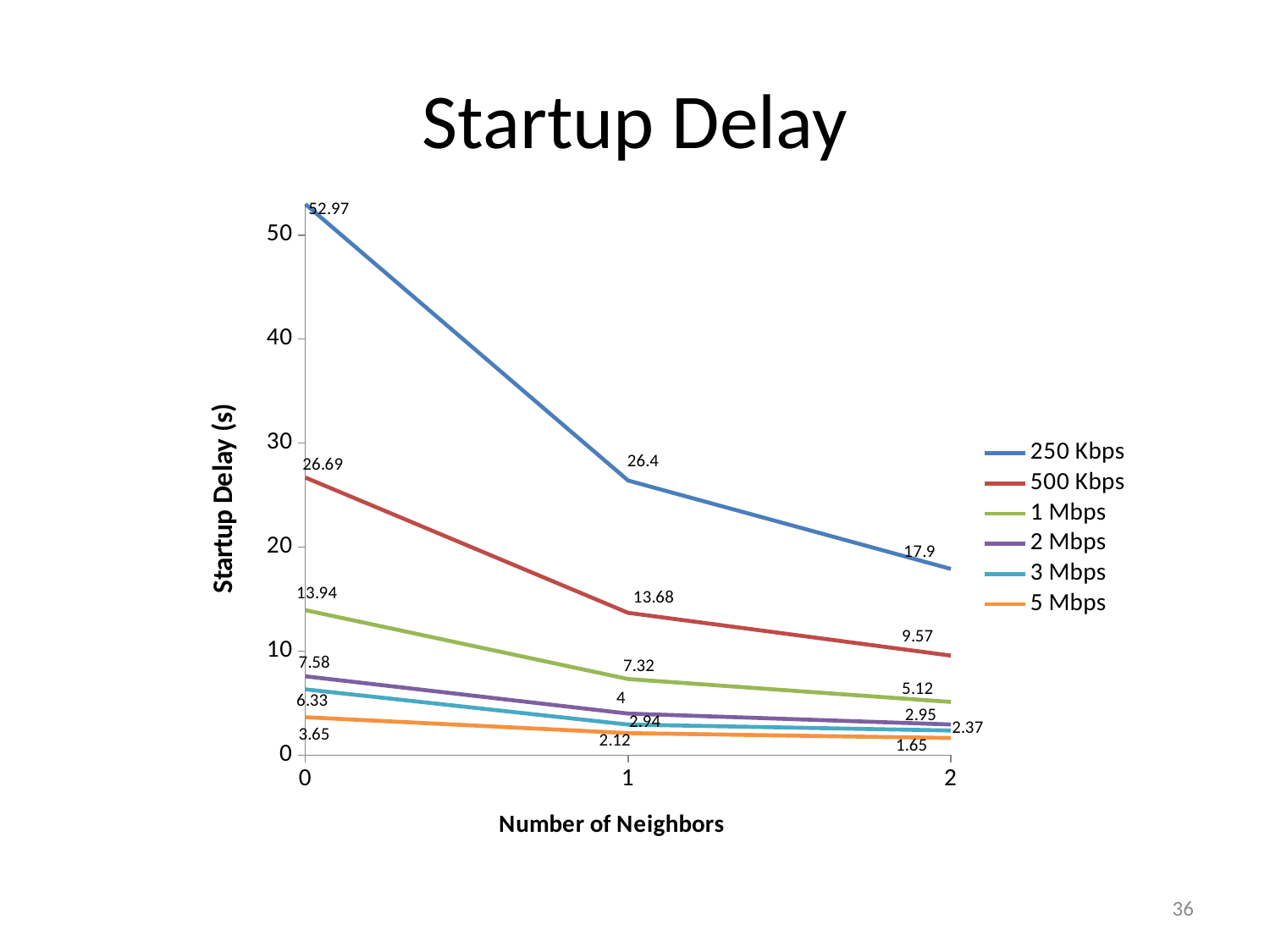
What is the startup delay for 1 Mbps at 2 neighbors? 5.12 What is the startup delay for 500 Kbps at 1 neighbor? 13.68 Which series has the highest startup delay at 2 neighbors? 250 Kbps What kind of chart is shown on the slide? Line chart Does the startup delay for 250 Kbps rise or fall as the number of neighbors increases? Fall What is the startup delay for 250 Kbps at 0 neighbors? 52.97 Which series has the lowest startup delay at 0 neighbors? 5 Mbps Which is larger: the 500 Kbps delay at 2 neighbors or the 1 Mbps delay at 0 neighbors? 1 Mbps delay at 0 neighbors What is the startup delay for 5 Mbps at 0 neighbors? 3.65 What is the label of the y axis? Startup Delay (s) What is the difference between the 250 Kbps startup delay at 0 neighbors and at 1 neighbor? 26.57 How many series does the legend list? 6